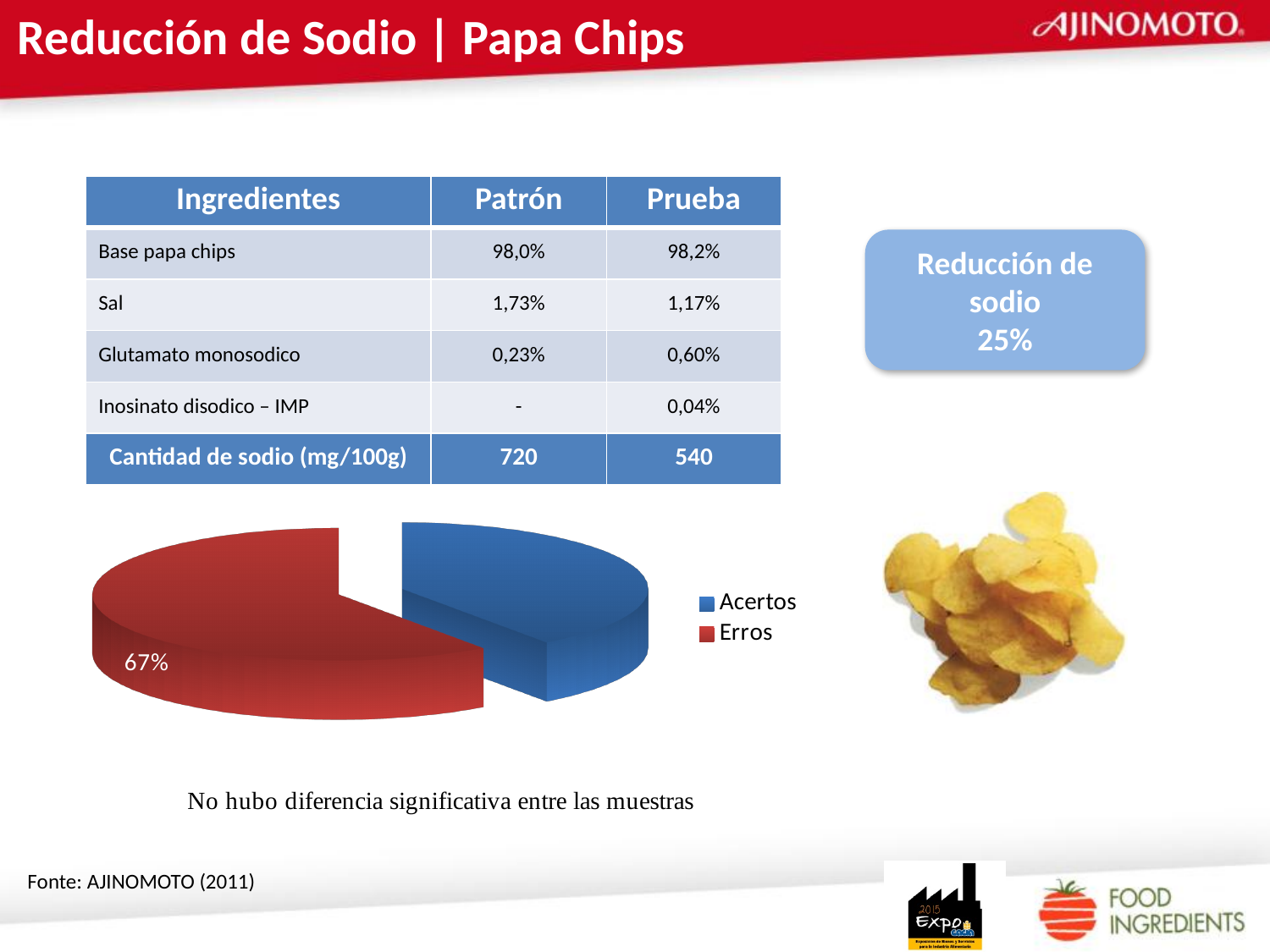
What kind of chart is shown on the slide? pie chart How many slices does the pie chart have? 2 Which slice of the pie chart has a percentage label printed on it? Erros What share of the pie chart does the Erros slice represent? 67% Which slice of the pie chart is the smallest? Acertos What colour is the Erros slice in the pie chart? red Which is larger in the pie chart, Acertos or Erros? Erros What colour is the Acertos slice in the pie chart? blue Which slice of the pie chart is the largest? Erros How many entries does the legend of the pie chart list? 2